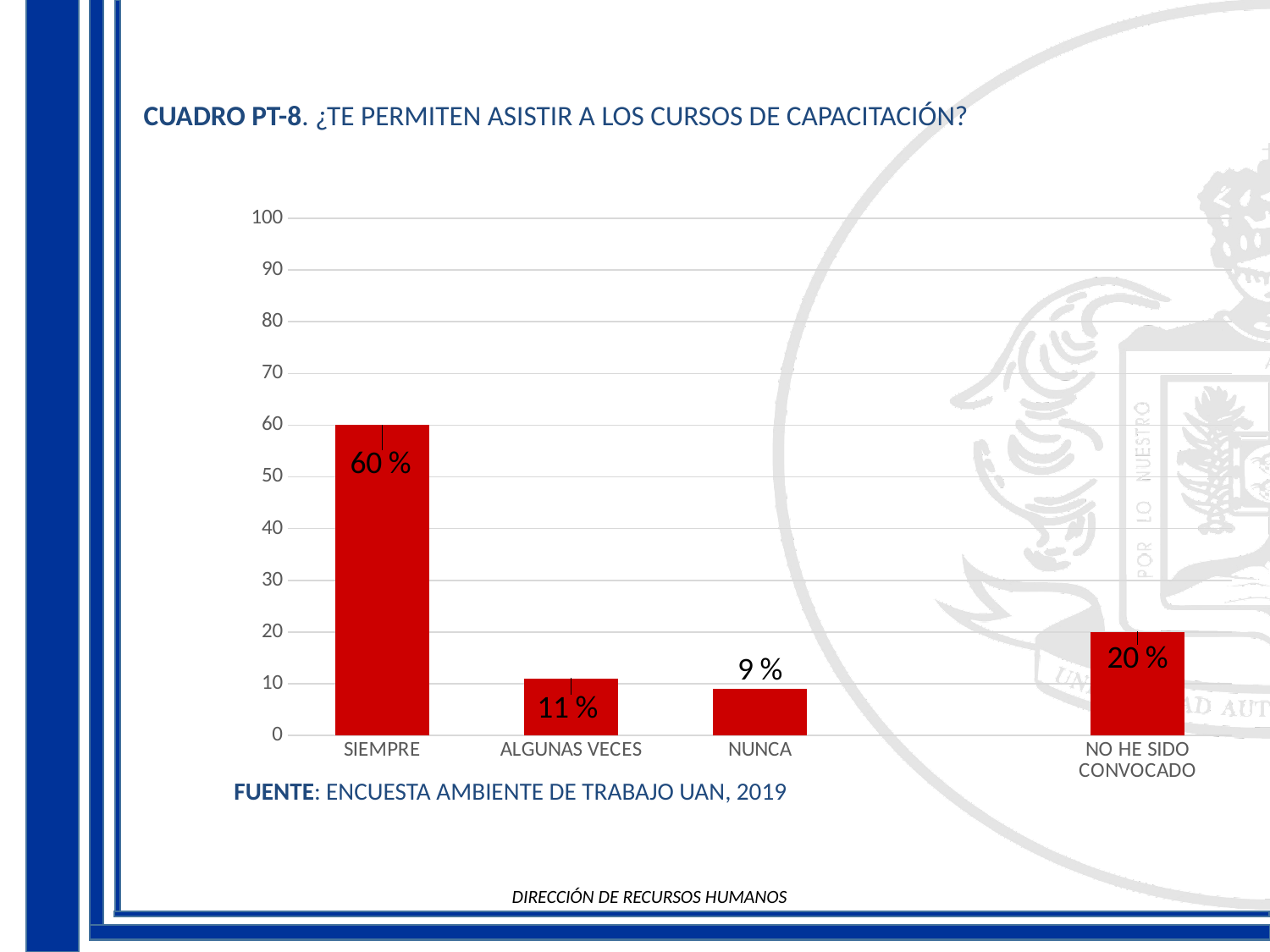
Which is larger, the value for ALGUNAS VECES or the value for NO HE SIDO CONVOCADO? NO HE SIDO CONVOCADO What is the value for SIEMPRE? 60 % Which category has the highest value? SIEMPRE What kind of chart is shown on the slide? bar chart What is the value for ALGUNAS VECES? 11 % What is the difference between the values for SIEMPRE and NO HE SIDO CONVOCADO? 40 % What is the value for NUNCA? 9 % Which category has the lowest value? NUNCA Is the value for SIEMPRE greater or less than 50? greater What is the source cited below the chart? ENCUESTA AMBIENTE DE TRABAJO UAN, 2019 How many categories are shown on the x axis? 4 What is the value for NO HE SIDO CONVOCADO? 20 %